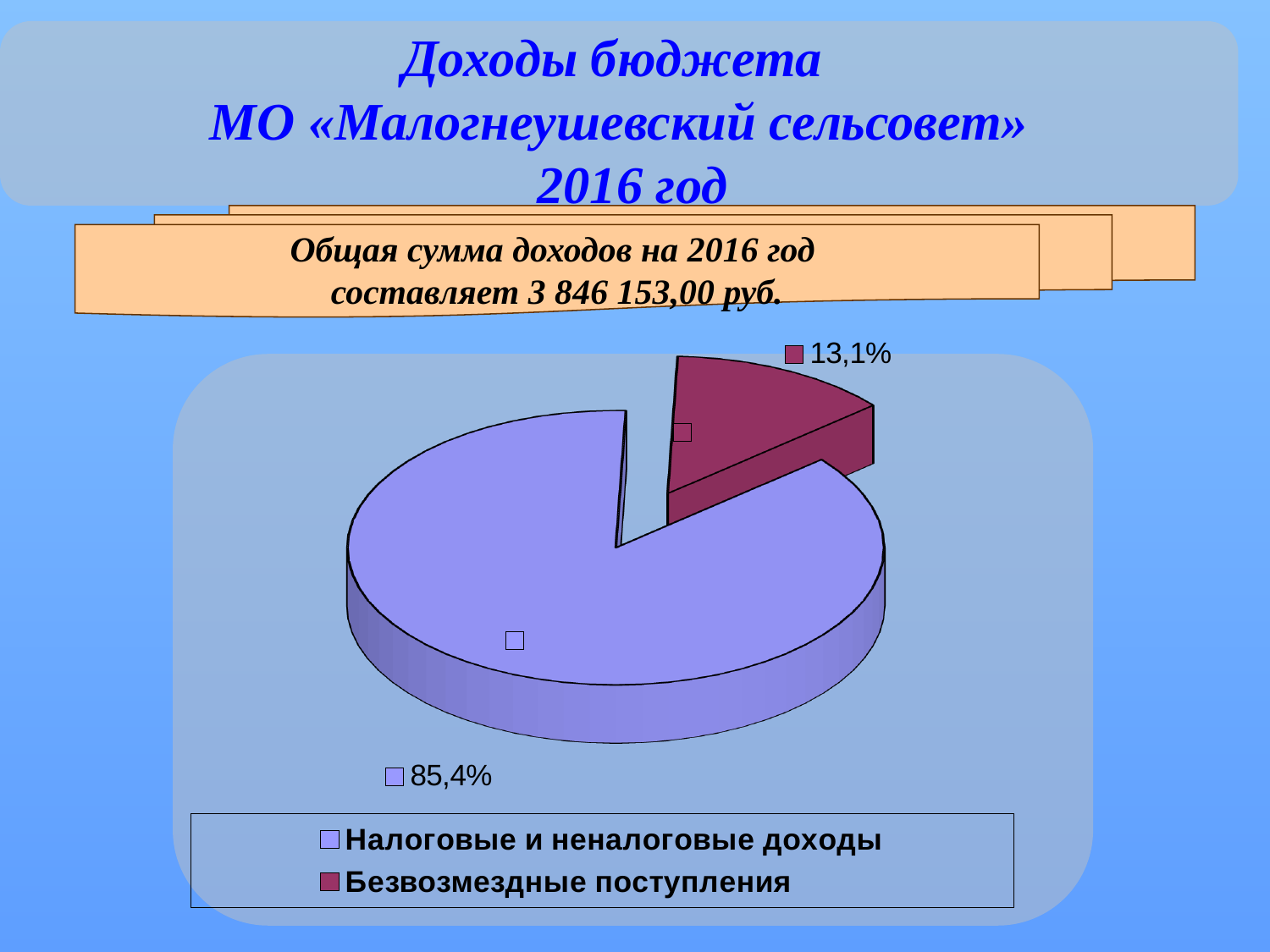
What colour is the slice for "Безвозмездные поступления"? dark magenta Which category has the smallest slice of the pie? Безвозмездные поступления What share of the pie does "Безвозмездные поступления" take? 13,1% What total income amount for 2016 is stated above the chart? 3 846 153,00 руб. Which is larger: the slice for "Налоговые и неналоговые доходы" or the slice for "Безвозмездные поступления"? Налоговые и неналоговые доходы What share of the pie does "Налоговые и неналоговые доходы" take? 85,4% What is the difference in percentage points between the "Налоговые и неналоговые доходы" slice and the "Безвозмездные поступления" slice? 72,3 How many slices does the pie chart have? 2 Which category has the largest slice of the pie? Налоговые и неналоговые доходы How many entries does the legend list? 2 What kind of chart is shown on the slide? pie chart